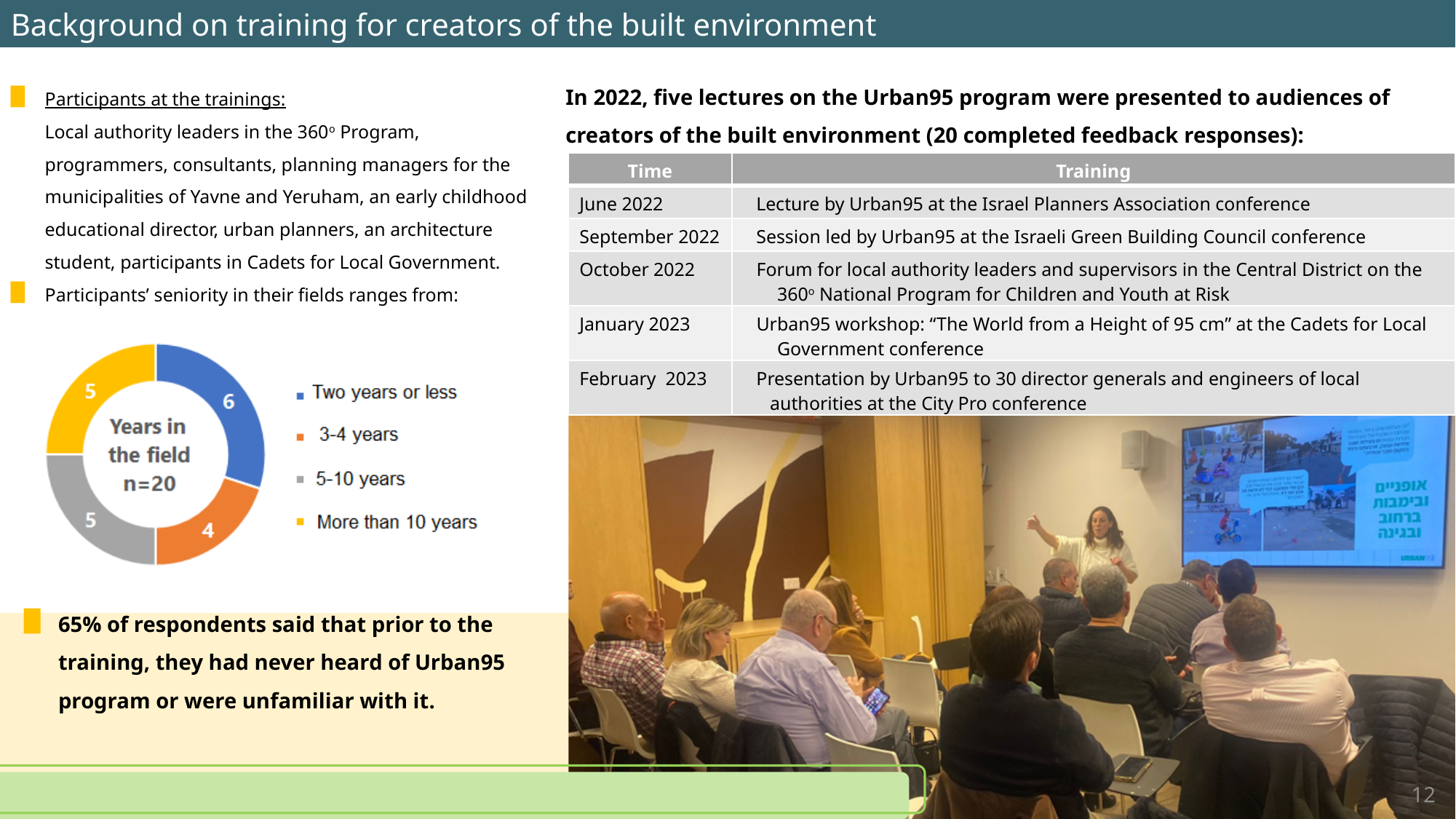
In the 'Years in the field' chart, which is larger: 'Two years or less' or '5-10 years'? Two years or less In the 'Years in the field' chart, how many participants have two years or less in the field? 6 In the 'Years in the field' chart, how many participants have more than 10 years in the field? 5 In the 'Years in the field' chart, how many participants have 3-4 years in the field? 4 What is the sample size (n) shown in the centre of the 'Years in the field' chart? n=20 In the 'Years in the field' chart, what is the difference between the 'Two years or less' and '3-4 years' values? 2 What kind of chart is used to show 'Years in the field'? Donut (pie) chart Which category in the 'Years in the field' chart has the smallest value? 3-4 years In the 'Years in the field' chart, how many participants have 5-10 years in the field? 5 How many categories does the 'Years in the field' chart show? 4 Which category in the 'Years in the field' chart has the largest value? Two years or less What share of the 'Years in the field' chart does the 'Two years or less' slice represent? 30%